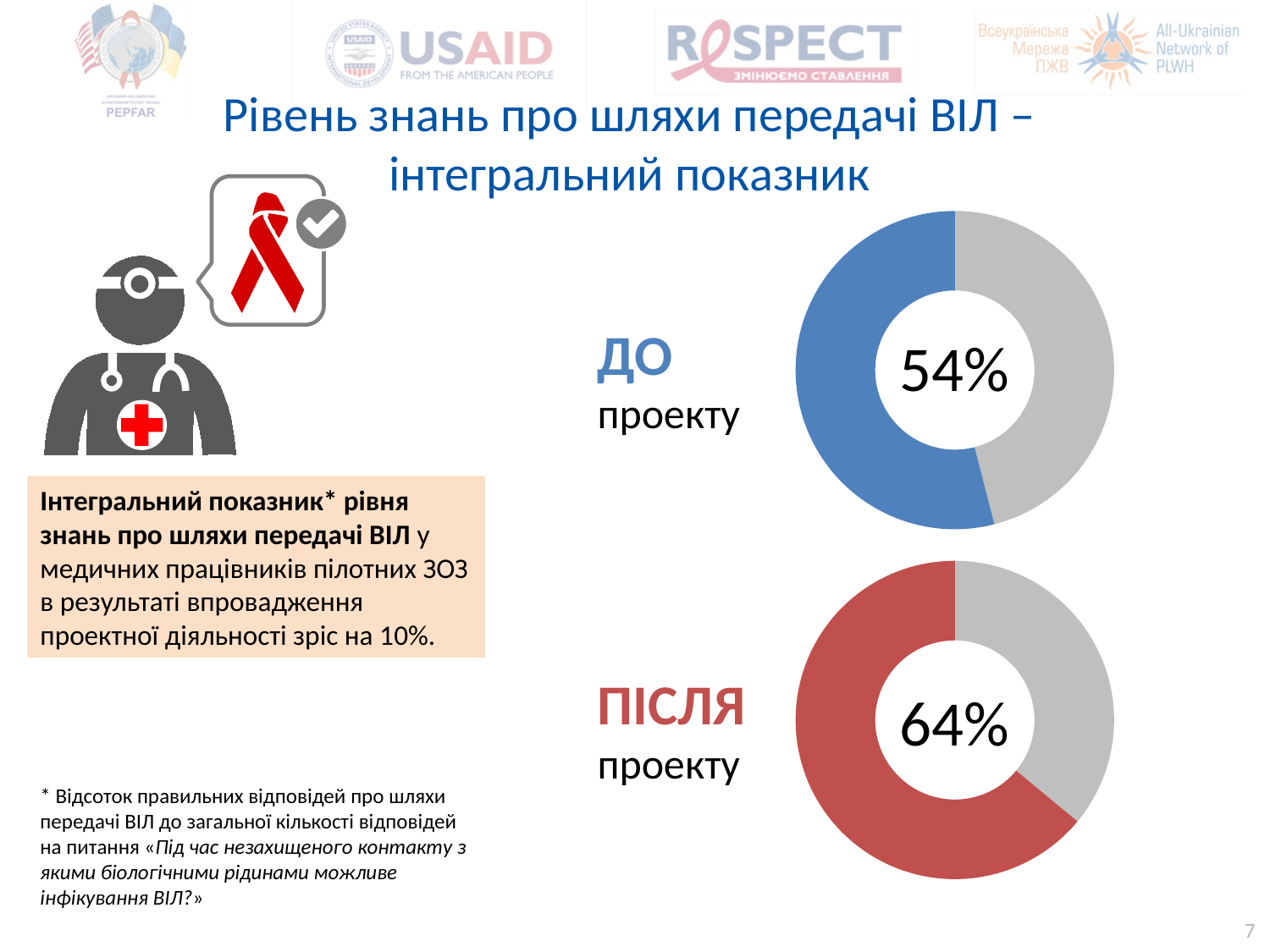
Does the value rise or fall from the "ДО проекту" chart to the "ПІСЛЯ проекту" chart? Rises What colour is the filled segment of the "ПІСЛЯ проекту" donut chart? Red What value is shown in the centre of the top donut chart labelled "ДО проекту"? 54% How many donut charts are shown on the slide? 2 What colour is the filled segment of the "ДО проекту" donut chart? Blue What value is shown in the centre of the bottom donut chart labelled "ПІСЛЯ проекту"? 64% Which of the two donut charts shows the higher value, "ДО проекту" or "ПІСЛЯ проекту"? ПІСЛЯ проекту In the bottom donut chart ("ПІСЛЯ проекту"), what share of the ring is coloured red? 64% In the top donut chart ("ДО проекту"), what share of the ring is coloured blue? 54% By how many percentage points does the value in the "ПІСЛЯ проекту" chart exceed the value in the "ДО проекту" chart? 10 Which of the two donut charts shows the lower value, "ДО проекту" or "ПІСЛЯ проекту"? ДО проекту What kind of chart is used to show the "ДО проекту" value? Donut (pie) chart